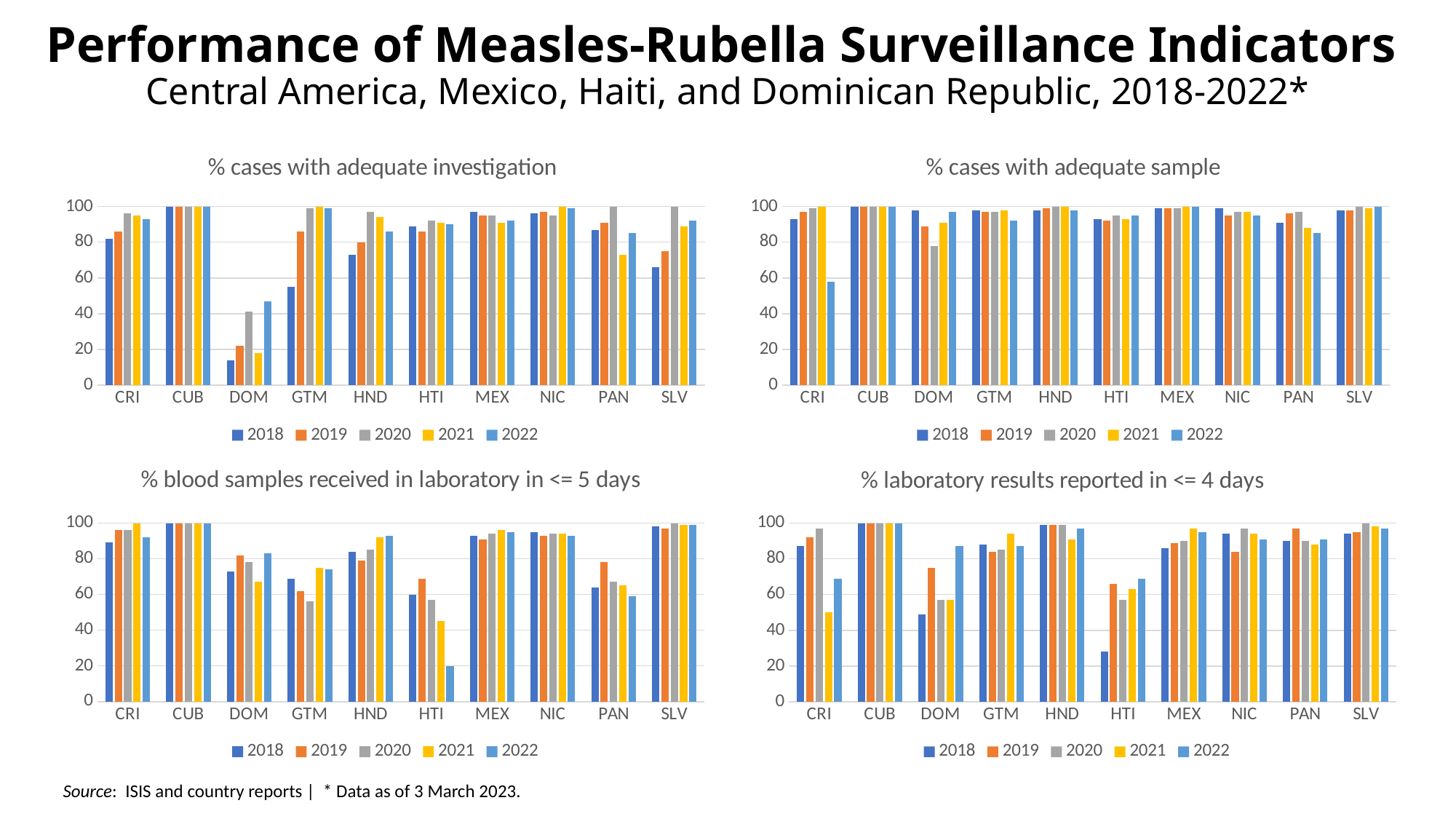
In the '% cases with adequate investigation' chart, which country has the lowest bar for 2018? DOM In the '% cases with adequate sample' chart, which year has the lowest bar for CRI? 2022 What are the legend entries of the '% laboratory results reported in <= 4 days' chart? 2018, 2019, 2020, 2021, 2022 In the '% cases with adequate sample' chart, is the 2022 value for CRI greater or less than 80? less In the '% laboratory results reported in <= 4 days' chart, is the 2018 value for HTI greater or less than 40? less In the '% blood samples received in laboratory in <= 5 days' chart, which is larger for DOM: the 2019 value or the 2021 value? 2019 What kind of chart is the '% blood samples received in laboratory in <= 5 days' chart? bar chart How many countries are shown on the x axis of the '% cases with adequate sample' chart? 10 How many series does the legend of the '% cases with adequate sample' chart list? 5 In the '% cases with adequate investigation' chart, is the 2018 value for DOM greater or less than 20? less In the '% laboratory results reported in <= 4 days' chart, which is larger for CRI: the 2020 value or the 2021 value? 2020